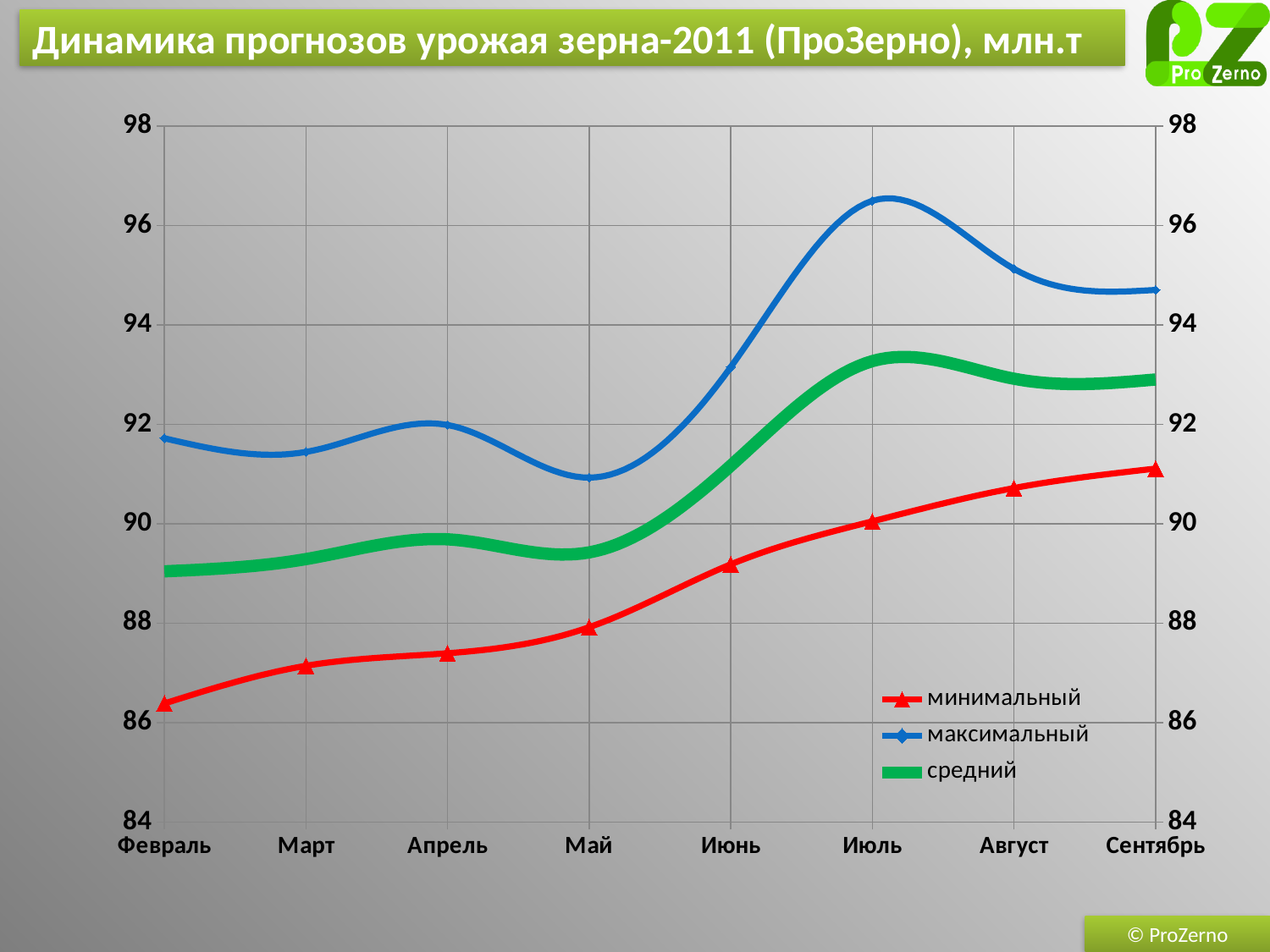
For the максимальный series, which month has the larger value: Апрель or Май? Апрель Is the value for максимальный in Июль greater or less than 96? greater Is the value for средний in Сентябрь greater or less than 92? greater What kind of chart is shown on the slide? line chart How many months are shown on the x axis? 8 How many series does the legend list? 3 What colour is the line for the средний series? green In which month is the минимальный series at its lowest value? Февраль Is the value for минимальный in Февраль greater or less than 88? less Does the минимальный series rise or fall from Февраль to Сентябрь? rise In which month does the максимальный series reach its highest value? Июль